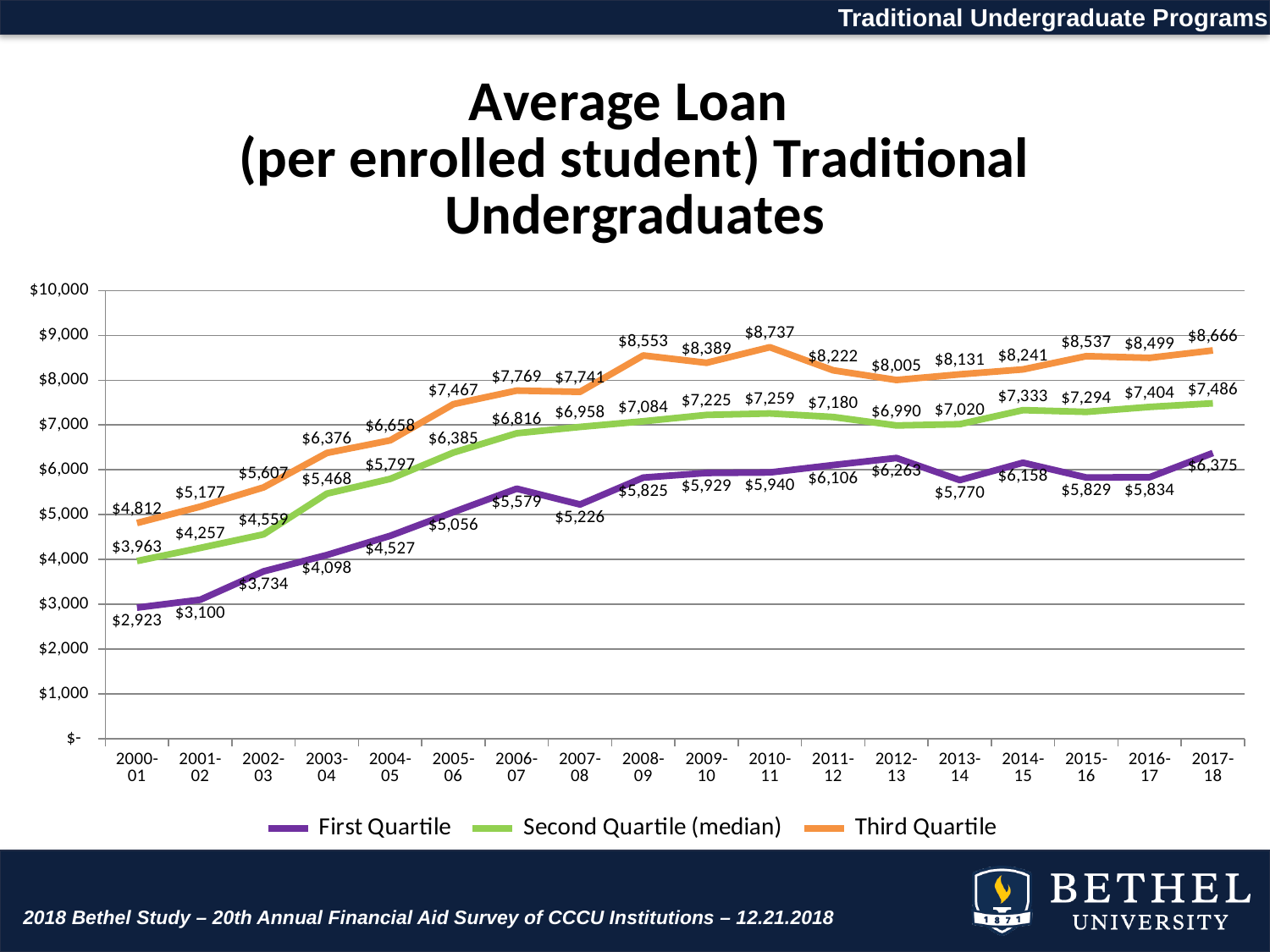
What is the First Quartile value for 2000-01? $2,923 What kind of chart is shown on the slide? Line chart How many academic years are plotted on the x axis? 18 In which year is the First Quartile at its lowest value? 2000-01 What is the Third Quartile value for 2010-11? $8,737 Does the Second Quartile (median) line generally rise or fall from 2000-01 to 2017-18? Rise In which year does the Third Quartile reach its highest value? 2010-11 How many series does the legend list? 3 Which year has the larger First Quartile value, 2012-13 or 2013-14? 2012-13 What is the difference between the Third Quartile and First Quartile values in 2017-18? $2,291 What is the Second Quartile (median) value for 2017-18? $7,486 Which series is shown by the green line? Second Quartile (median)